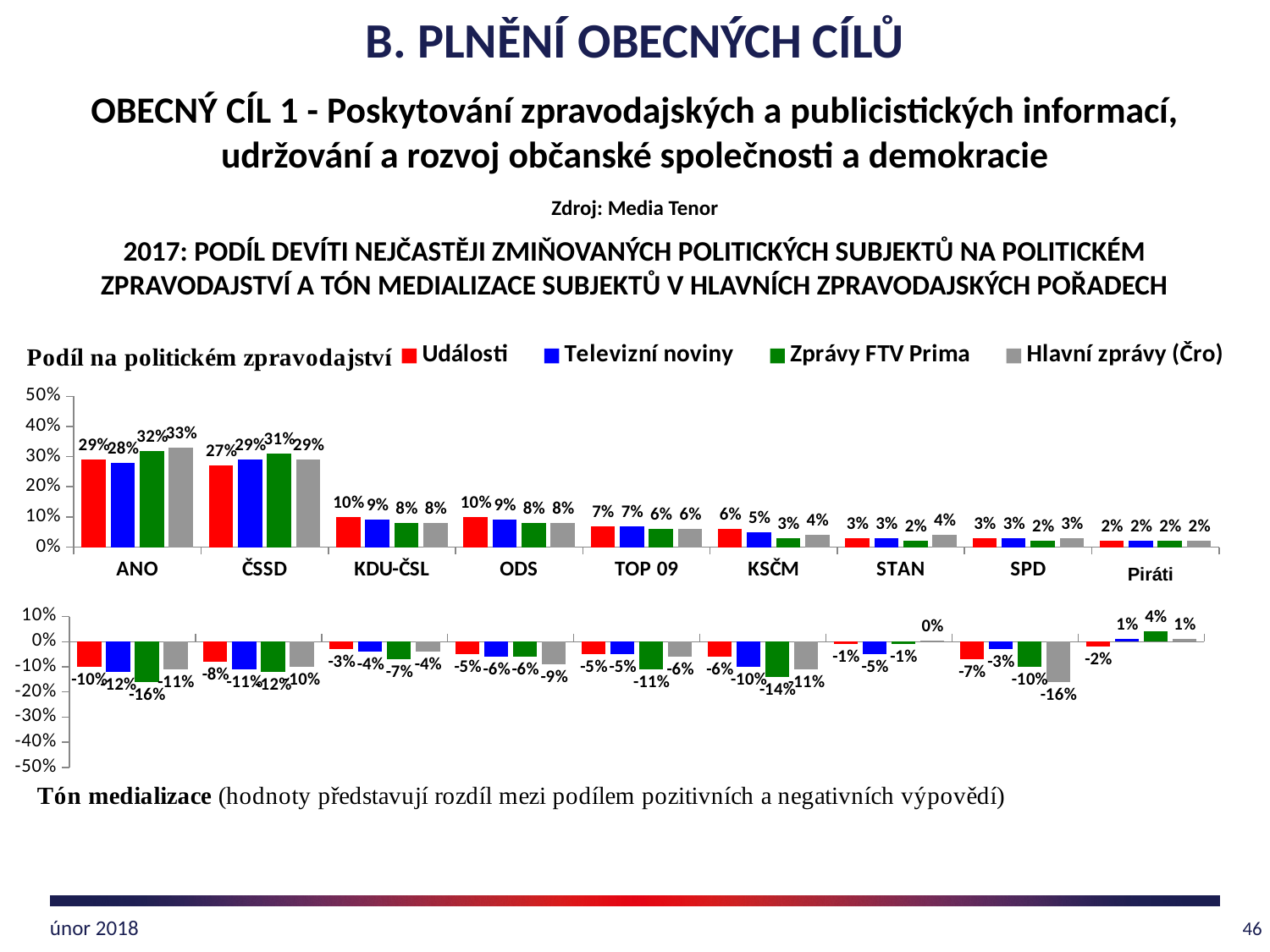
In the bottom chart (Tón medializace), what is the value for SPD in the Hlavní zprávy (Čro) series? -16% In the top chart (Podíl na politickém zpravodajství), what is the value for ČSSD in the Zprávy FTV Prima series? 31% In the bottom chart (Tón medializace), what is the value for Piráti in the Zprávy FTV Prima series? 4% In the top chart (Podíl na politickém zpravodajství), which category has the highest value in the Události series? ANO In the bottom chart (Tón medializace), which is larger for KSČM: the Události value or the Zprávy FTV Prima value? Události Which series is shown in green in the legend? Zprávy FTV Prima How many political subjects (categories) are shown on the x axis of the top chart? 9 How many series does the legend list? 4 In the bottom chart (Tón medializace), which category has the lowest value in the Zprávy FTV Prima series? ANO What kind of chart is the top chart (Podíl na politickém zpravodajství)? Bar chart In the top chart (Podíl na politickém zpravodajství), what is the value for ANO in the Hlavní zprávy (Čro) series? 33% In the top chart (Podíl na politickém zpravodajství), what is the difference between the Hlavní zprávy (Čro) value for ANO and the Hlavní zprávy (Čro) value for ČSSD? 4%